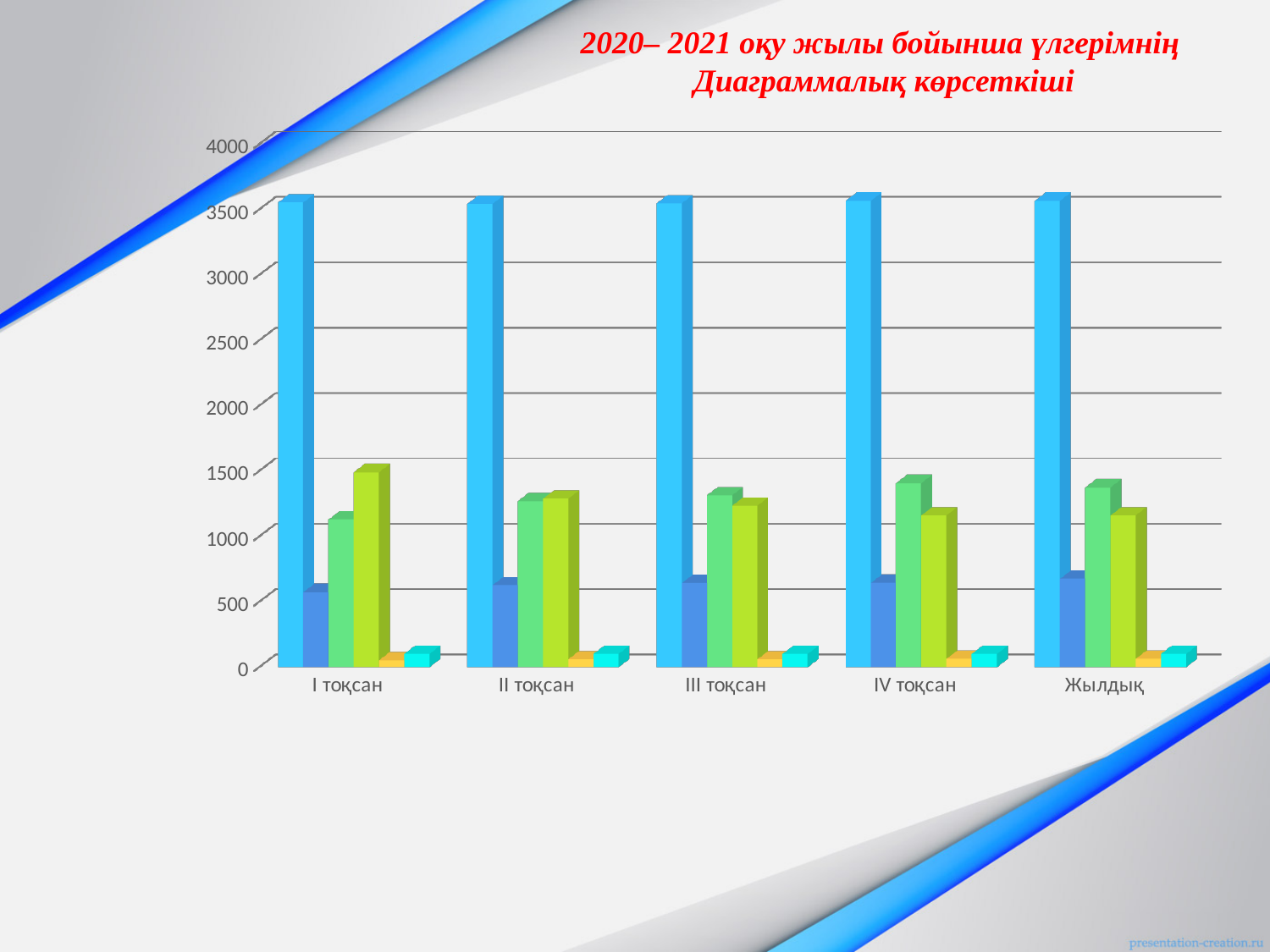
Is the value of the tallest (light blue) bar for I тоқсан greater or less than 3000? greater Is the value of the dark blue bar for I тоқсан greater or less than 1000? less What kind of chart is shown on the slide? Bar chart Which bar is the tallest in the Жылдық group? The light blue bar How many bars are plotted for each category on the chart? 6 How many categories are shown on the x axis of the chart? 5 Do the yellow-green bars rise or fall from I тоқсан to IV тоқсан? Fall Which bar is the shortest in the I тоқсан group? The orange bar In the I тоқсан group, which is larger: the green bar or the yellow-green bar? The yellow-green bar What is the title of the chart on the slide? 2020– 2021 оқу жылы бойынша үлгерімнің Диаграммалық көрсеткіші Is the value of the yellow-green bar for I тоқсан greater or less than 1000? greater